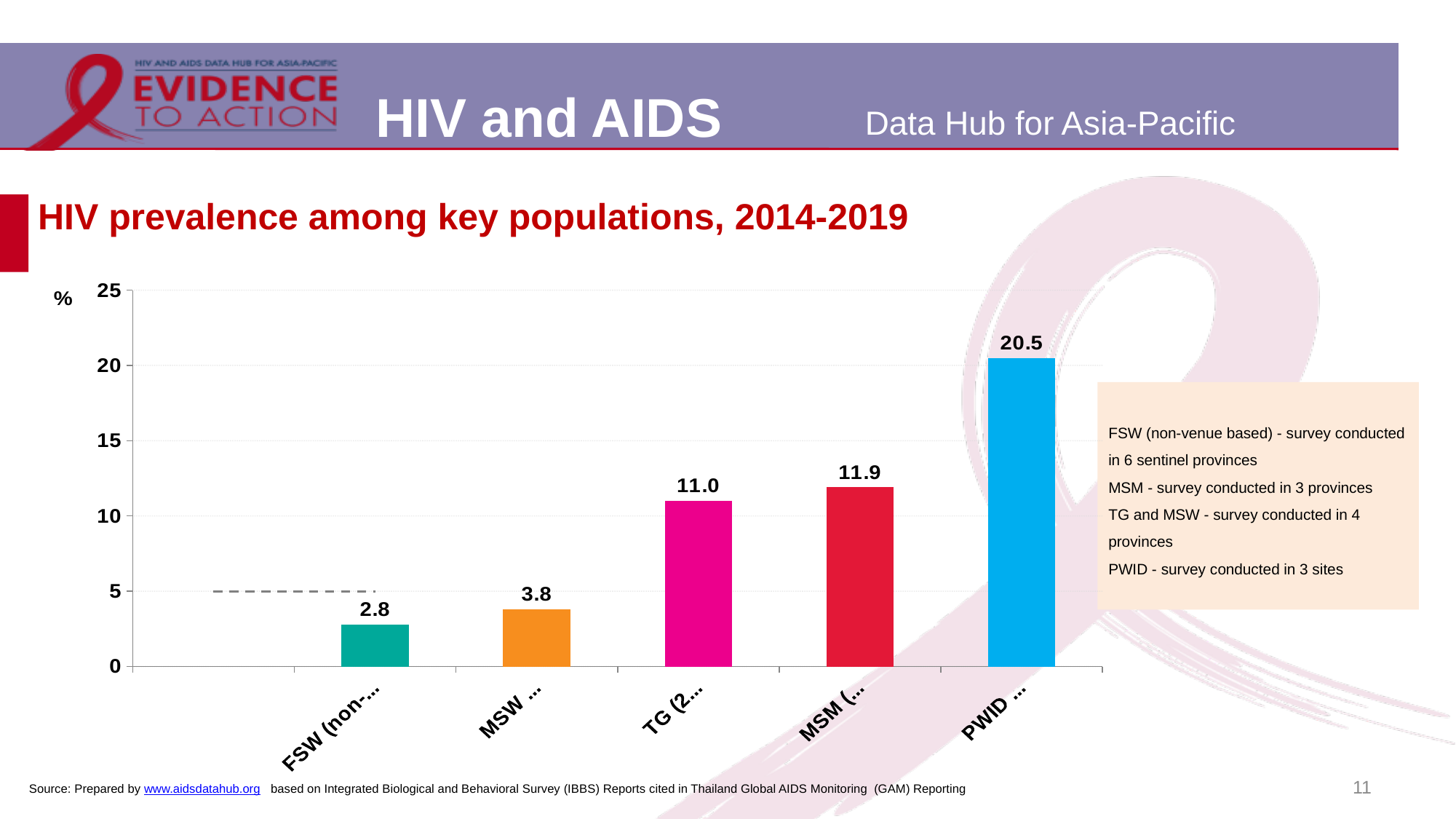
How many bars are plotted in the chart? 5 What is the value shown for the TG bar? 11.0 What is the HIV prevalence value shown for the PWID bar? 20.5 Which is larger, the value for MSM or the value for TG? MSM What is the value shown for the MSW bar? 3.8 Which key population has the lowest HIV prevalence in the chart? FSW (non-venue based) What is the title of the chart? HIV prevalence among key populations, 2014-2019 Is the value for PWID greater or less than 20? greater What is the difference between the PWID value and the MSM value? 8.6 What kind of chart is shown on the slide? Bar chart What is the value shown for the FSW (non-venue based) bar? 2.8 Which key population has the highest HIV prevalence in the chart? PWID